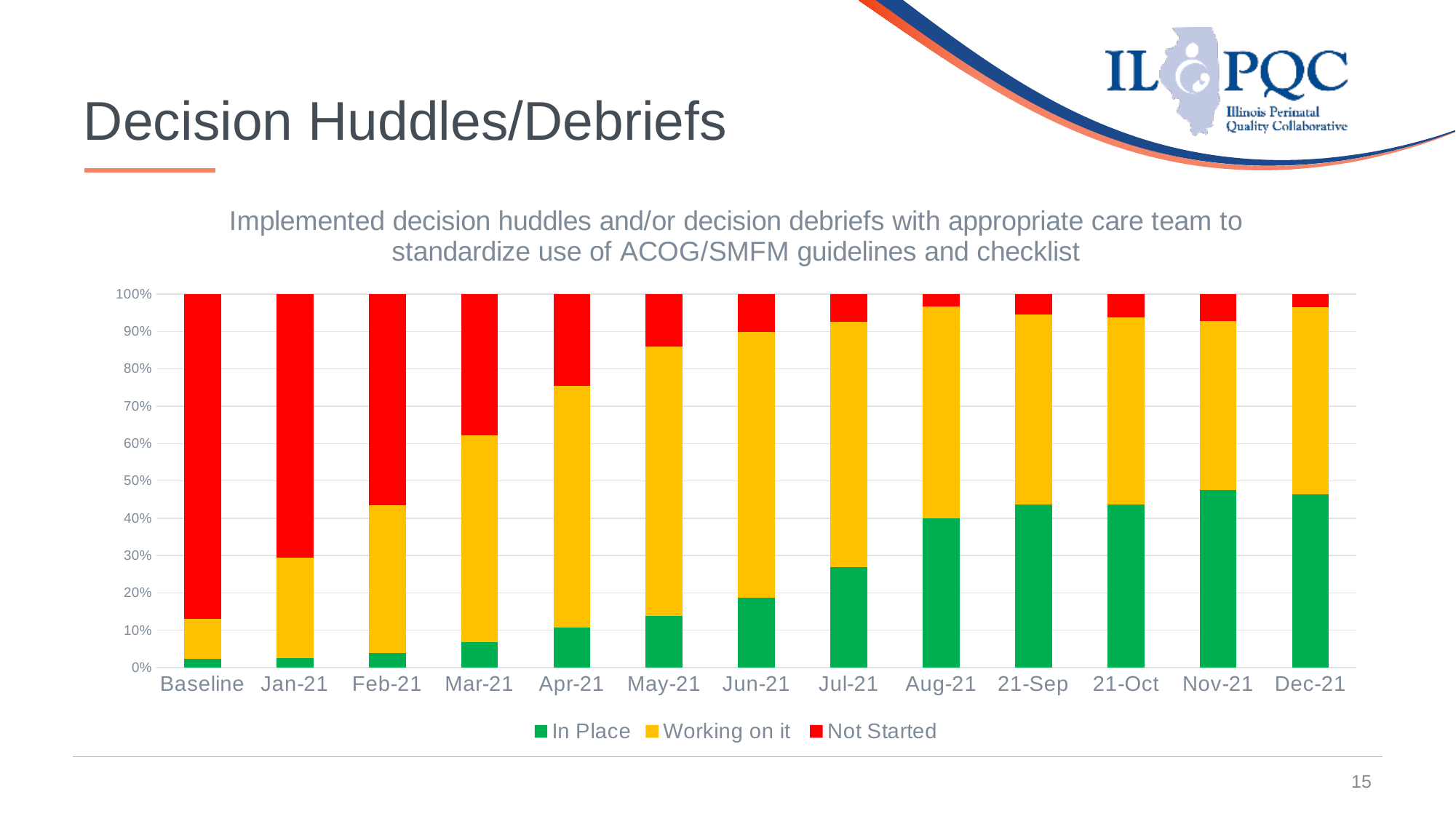
Is the "Not Started" value for Jan-21 greater or less than 60%? greater Does the "In Place" share rise or fall from Baseline to Dec-21? rise Is the "In Place" value for Aug-21 greater or less than 30%? greater What is the total of the stacked bar for Baseline? 100% Which is larger, the "In Place" value for Jul-21 or for Jun-21? Jul-21 How many series does the legend list? 3 What kind of chart is shown on the slide? Stacked bar chart How many categories are shown along the x axis? 13 What colour represents "Not Started" in the legend? Red Which category has the smallest "Working on it" segment? Baseline Is the "In Place" value for Baseline greater or less than 10%? less Which category has the largest "Not Started" segment? Baseline